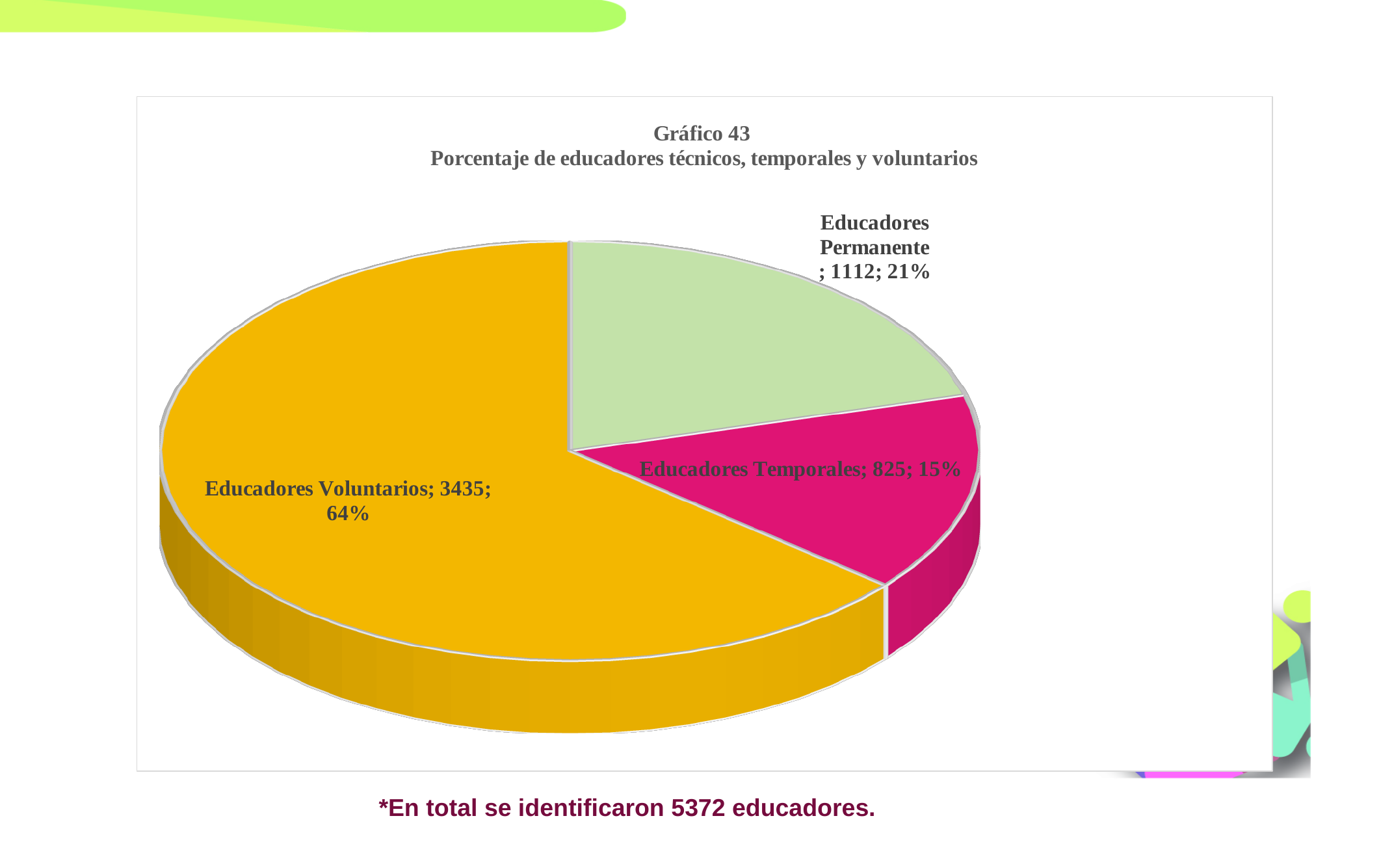
Which category has the largest slice? Educadores Voluntarios What share of the pie does Educadores Temporales represent? 15% What is the difference between the values for Educadores Permanente and Educadores Temporales? 287 How many slices does the pie chart have? 3 What is the title of the chart? Gráfico 43 Porcentaje de educadores técnicos, temporales y voluntarios What is the value for Educadores Temporales? 825 What share of the pie does Educadores Voluntarios represent? 64% Which is larger, the value for Educadores Permanente or Educadores Temporales? Educadores Permanente What is the value for Educadores Permanente? 1112 What kind of chart is shown on the slide? Pie chart What is the value for Educadores Voluntarios? 3435 Which category has the smallest slice? Educadores Temporales